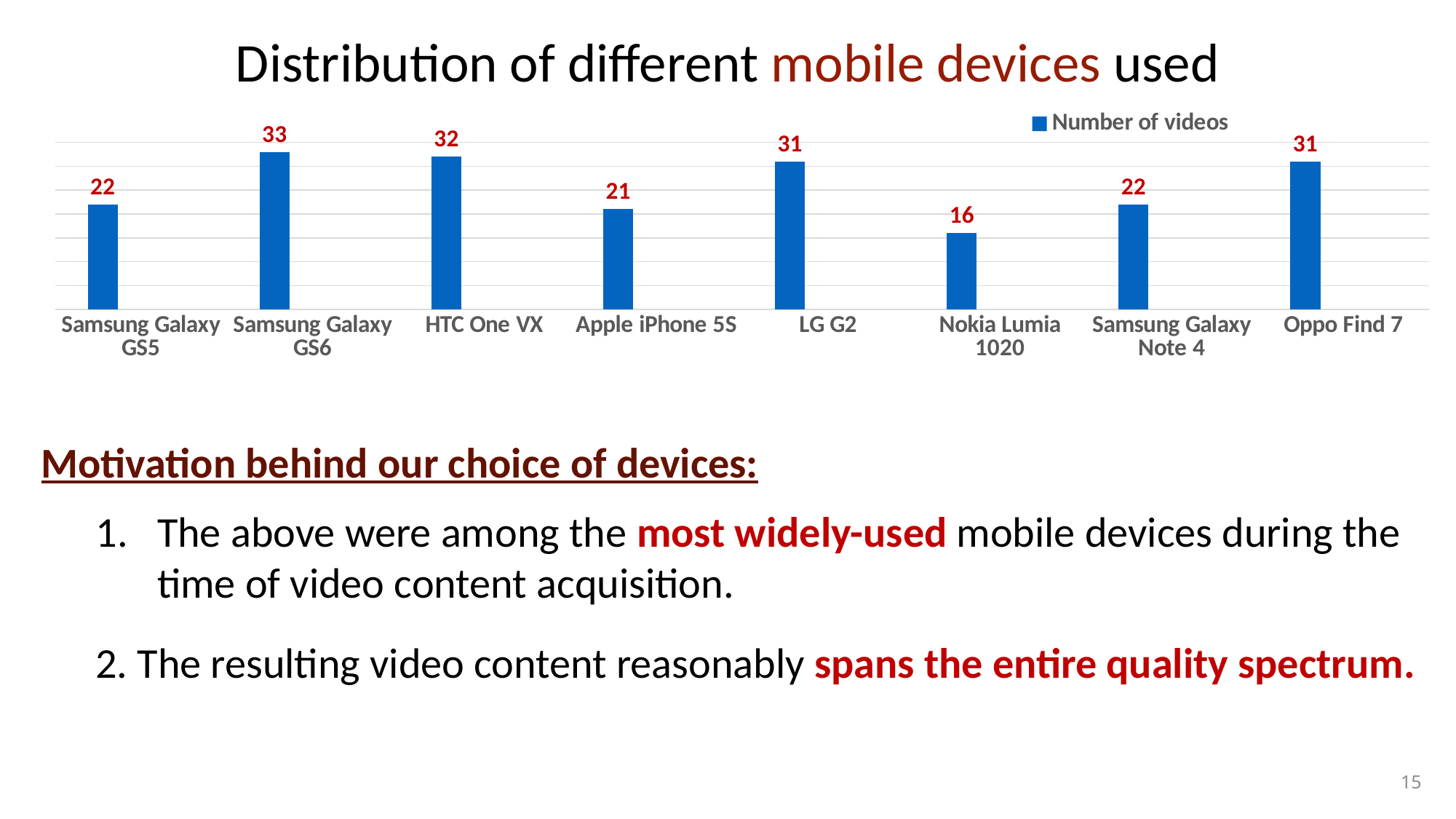
What is the difference in number of videos between the Samsung Galaxy GS6 and the Nokia Lumia 1020? 17 What kind of chart is shown on the slide? Bar chart How many devices are shown in the chart? 8 What is the difference in number of videos between the HTC One VX and the Apple iPhone 5S? 11 Which has more videos, the LG G2 or the Samsung Galaxy Note 4? LG G2 How many videos were recorded with the Samsung Galaxy GS6? 33 What is the legend entry of the chart? Number of videos What is the number of videos for the Apple iPhone 5S? 21 Which device has the highest number of videos? Samsung Galaxy GS6 Which device has the lowest number of videos? Nokia Lumia 1020 What is the number of videos for the Nokia Lumia 1020? 16 How many series does the legend list? 1